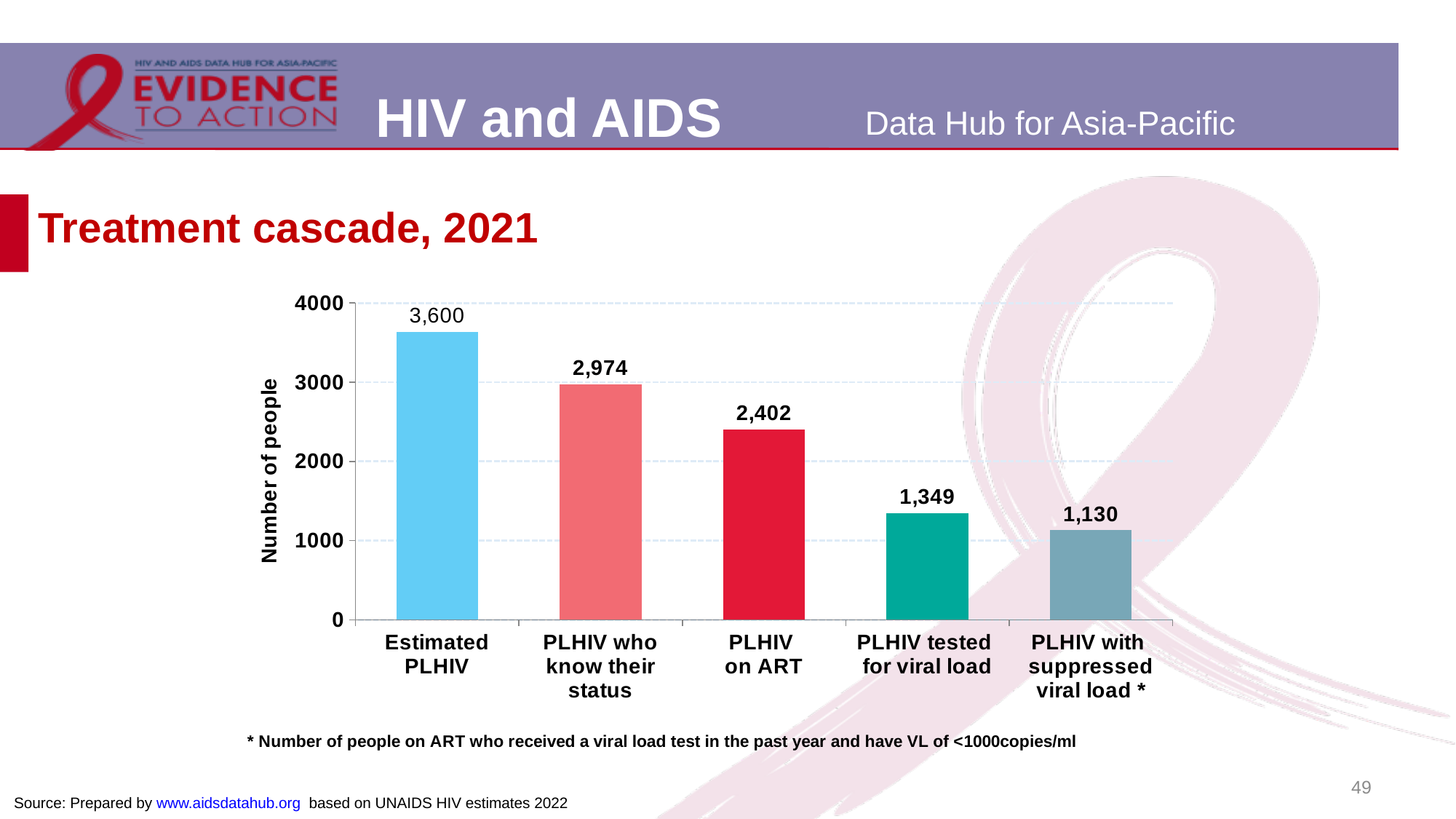
What is the value for PLHIV on ART? 2,402 How many categories are shown in the chart? 5 Which category has the lowest value? PLHIV with suppressed viral load What is the value for PLHIV with suppressed viral load? 1,130 What is the difference between Estimated PLHIV and PLHIV on ART? 1,198 Do the values rise or fall from left to right along the x axis? Fall Which category has the highest value? Estimated PLHIV What is the value for Estimated PLHIV? 3,600 What is the value for PLHIV tested for viral load? 1,349 What is the value for PLHIV who know their status? 2,974 Which is larger, PLHIV tested for viral load or PLHIV with suppressed viral load? PLHIV tested for viral load What kind of chart is shown on the slide? Bar chart